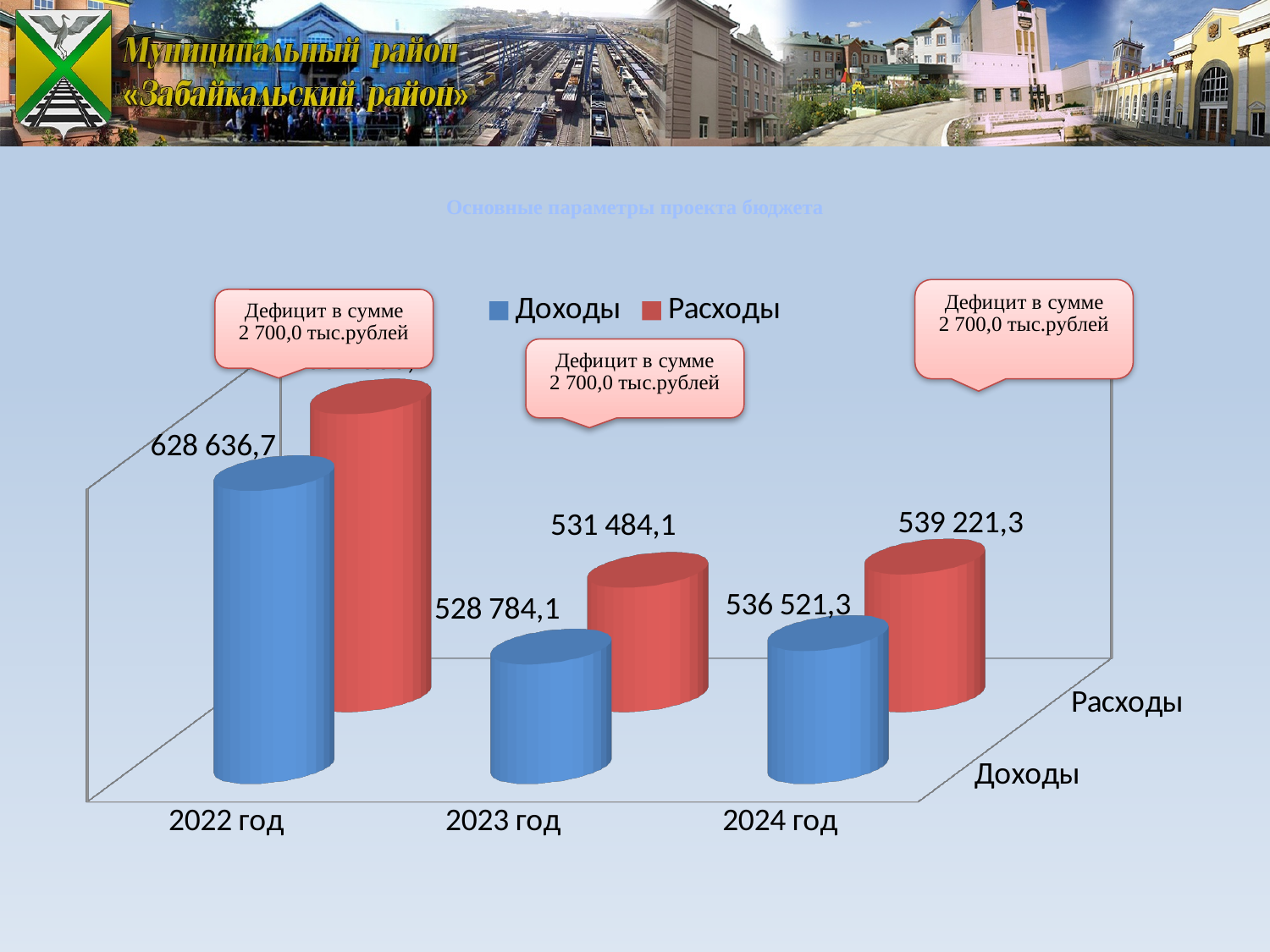
What kind of chart is shown on the slide? Bar chart What is the difference between Расходы and Доходы in 2024 год? 2 700,0 In which year is Доходы the highest? 2022 год How many series does the legend list? 2 What is the value of Расходы for 2023 год? 531 484,1 What is the value of Доходы for 2022 год? 628 636,7 What is the value of Доходы for 2024 год? 536 521,3 What is the value of Расходы for 2024 год? 539 221,3 How many years are shown on the chart? 3 In which year is Доходы the lowest? 2023 год What is the value of Доходы for 2023 год? 528 784,1 Which is larger in 2023 год, Доходы or Расходы? Расходы